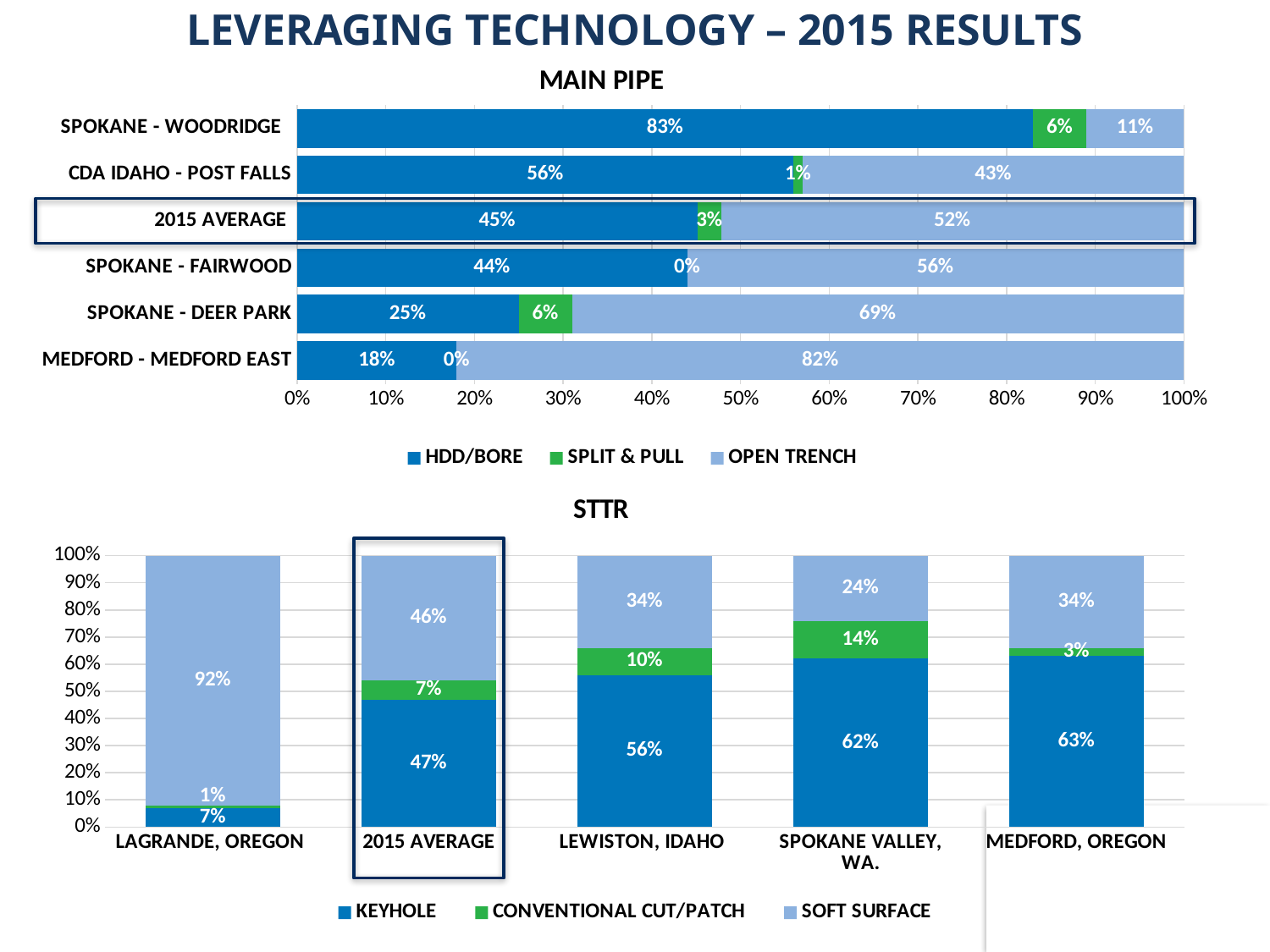
In the MAIN PIPE chart, how many series does the legend list? 3 In the MAIN PIPE chart, what is the HDD/BORE value for SPOKANE - WOODRIDGE? 83% In the MAIN PIPE chart, how many categories are shown? 6 What kind of chart is the STTR chart? stacked bar chart In the MAIN PIPE chart, what is the difference between the OPEN TRENCH values for MEDFORD - MEDFORD EAST and CDA IDAHO - POST FALLS? 39% In the STTR chart, what is the CONVENTIONAL CUT/PATCH value for LEWISTON, IDAHO? 10% In the MAIN PIPE chart, which category has the highest HDD/BORE value? SPOKANE - WOODRIDGE In the STTR chart, which category has the highest SOFT SURFACE value? LAGRANDE, OREGON In the STTR chart, what is the KEYHOLE value for SPOKANE VALLEY, WA.? 62% In the MAIN PIPE chart, which category has the lowest HDD/BORE value? MEDFORD - MEDFORD EAST In the MAIN PIPE chart, what is the OPEN TRENCH value for SPOKANE - DEER PARK? 69% In the STTR chart, is the KEYHOLE value for LAGRANDE, OREGON larger or smaller than the KEYHOLE value for MEDFORD, OREGON? smaller